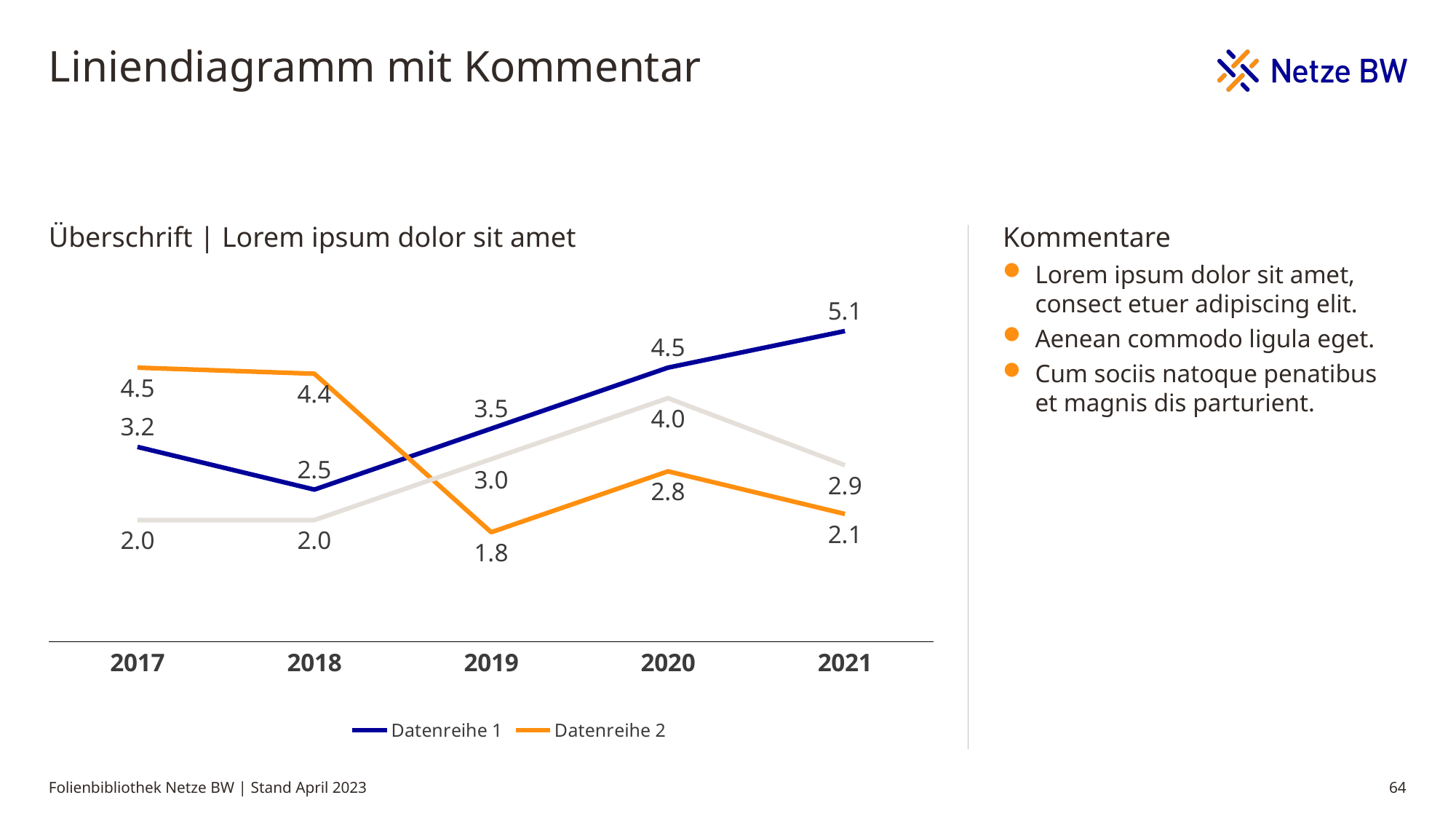
In 2018, which series has the higher value, Datenreihe 1 or Datenreihe 2? Datenreihe 2 Does Datenreihe 1 rise or fall from 2018 to 2021? Rise How many series does the legend list? 2 In which year does Datenreihe 1 reach its highest value? 2021 What is the difference between Datenreihe 2 in 2017 and in 2021? 2.4 What is the value of Datenreihe 2 in 2017? 4.5 What is the value of Datenreihe 1 in 2021? 5.1 By how much did Datenreihe 1 increase from 2017 to 2021? 1.9 What type of chart is shown on the slide? Line chart What is the value of Datenreihe 2 in 2019? 1.8 How many years are shown on the x axis? 5 In which year does Datenreihe 2 have its lowest value? 2019